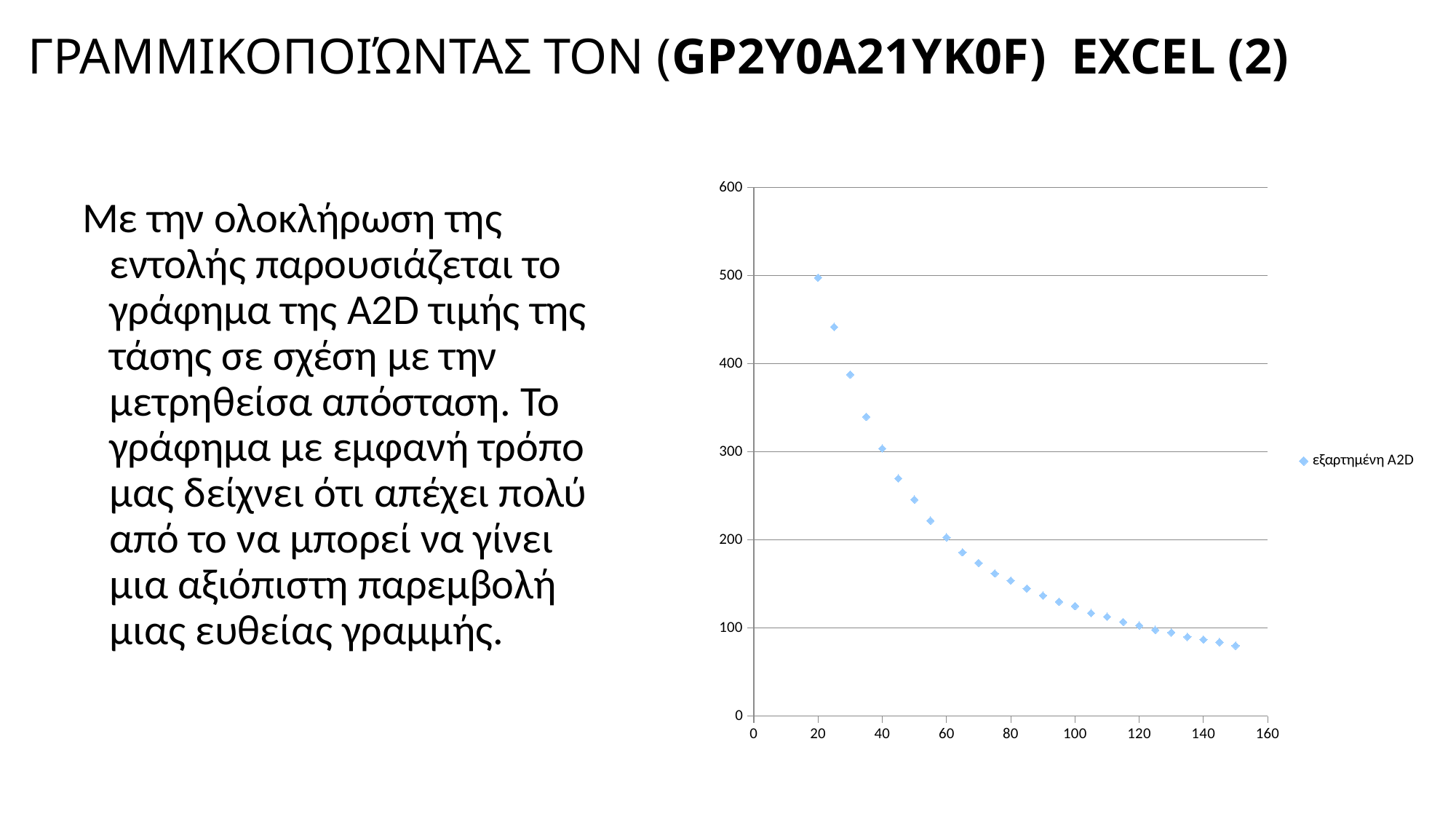
Is the value at x = 100 greater or less than 200? less What is the name of the series shown in the chart legend? εξαρτημένη A2D Which is larger, the value at x = 40 or the value at x = 80? x = 40 How many series does the chart legend list? 1 Is the value at x = 150 greater or less than 100? less At which x value is the plotted value lowest? 150 Do the plotted values rise or fall as the x value increases? fall Is the value at x = 20 greater or less than 400? greater What kind of chart is shown on the slide? scatter chart At which x value is the plotted value highest? 20 What is the maximum value shown on the vertical axis of the chart? 600